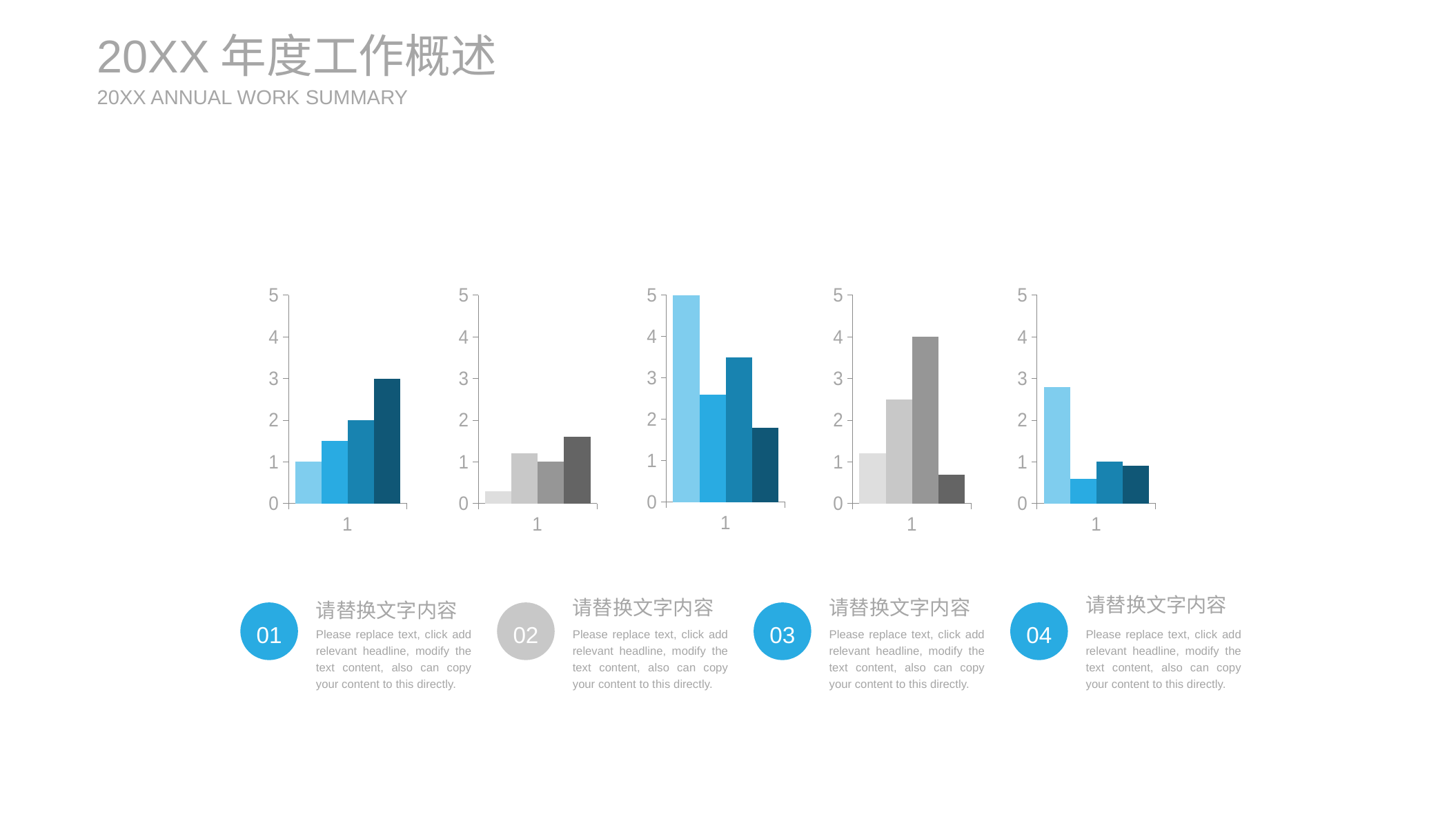
In the rightmost chart, is the value of the leftmost bar greater or less than 2? greater In the rightmost chart, which bar is the tallest? the lightest, leftmost bar In the middle chart, is the value of the second bar from the left greater or less than 2? greater In the middle chart, what value does the tallest (lightest, leftmost) bar reach? 5 How many bars does the leftmost chart show? 4 In the fourth chart from the left (grey bars), what value does the tallest bar reach? 4 How many bar charts are shown on the slide? 5 In the fourth chart from the left (grey bars), is the value of the rightmost bar greater or less than 1? less In the leftmost chart, what value does the tallest (darkest, rightmost) bar reach? 3 In the middle chart, which bar is the shortest? the darkest, rightmost bar In the leftmost chart, do the bars rise or fall from left to right? rise What kind of chart is the leftmost chart on the slide? bar chart